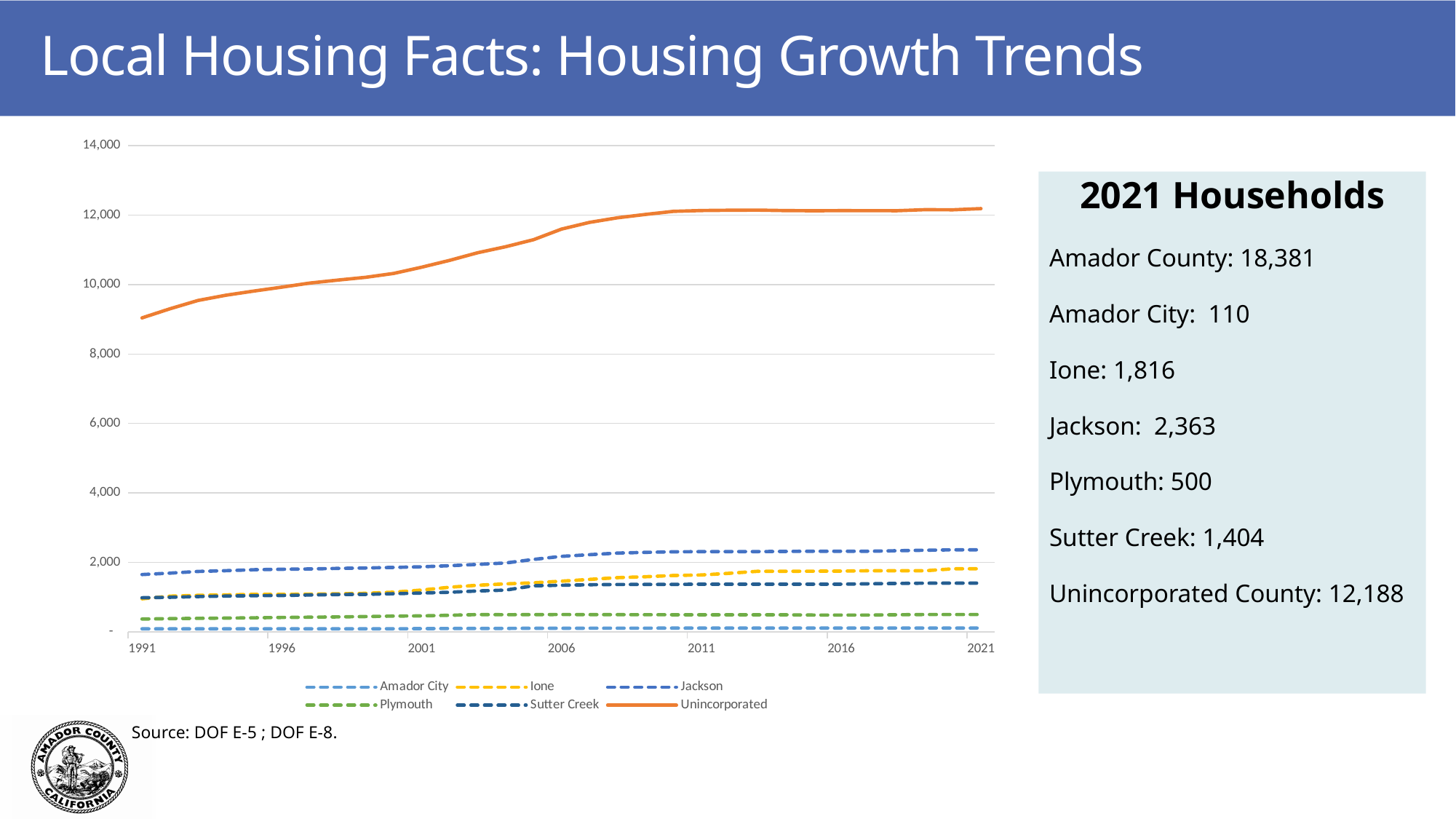
Is the value for Ione in 1991 greater or less than 2,000? less What is the difference between the 2021 household counts for Jackson and Ione shown on the slide? 547 Does the Unincorporated line rise or fall from 1991 to 2021? rise Which series has the lowest values throughout the chart? Amador City Is the value for Jackson in 2021 greater or less than 2,000? greater According to the slide, what is the 2021 household count for Unincorporated County? 12,188 Is the value for Unincorporated in 1991 greater or less than 10,000? less How many series does the chart's legend list? 6 What kind of chart is shown on the slide? line chart Which series has the highest values throughout the chart? Unincorporated In 2021, which is larger: Jackson or Ione? Jackson According to the slide, what is the 2021 household count for Sutter Creek? 1,404